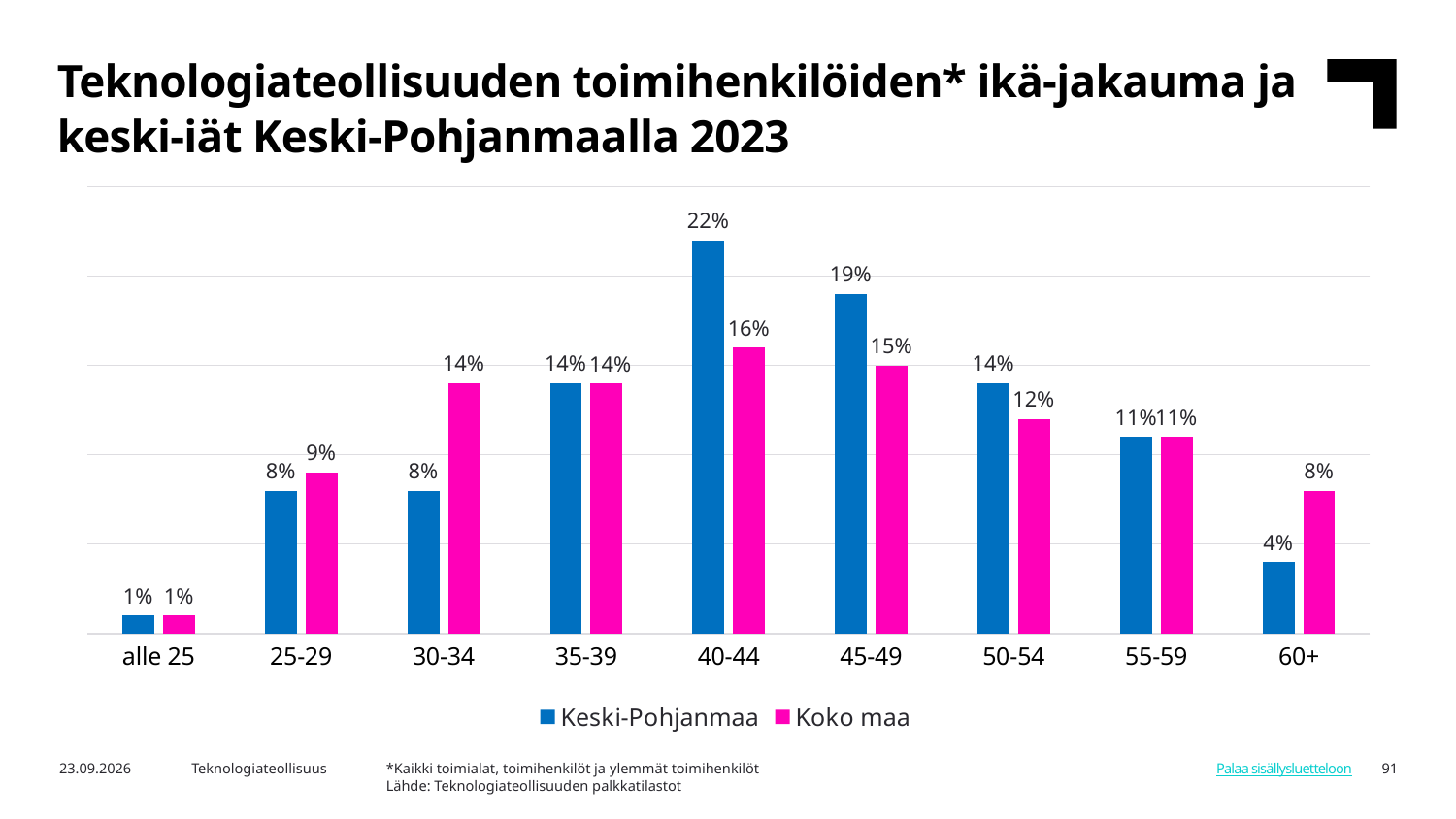
How many series does the legend list? 2 What is the difference between Keski-Pohjanmaa and Koko maa in the 40-44 age group? 6 percentage points Which age group has the lowest value for Koko maa? alle 25 What kind of chart is shown on the slide? Bar chart How many age groups are shown on the x axis? 9 What is the value for Koko maa in the 60+ age group? 8% Which colour represents Koko maa in the chart? Pink (magenta) Which age group has the highest value for Keski-Pohjanmaa? 40-44 What is the value for Keski-Pohjanmaa in the 40-44 age group? 22% What is the value for Koko maa in the 25-29 age group? 9% Which is larger in the 30-34 age group, Keski-Pohjanmaa or Koko maa? Koko maa Which is larger in the 45-49 age group, Keski-Pohjanmaa or Koko maa? Keski-Pohjanmaa